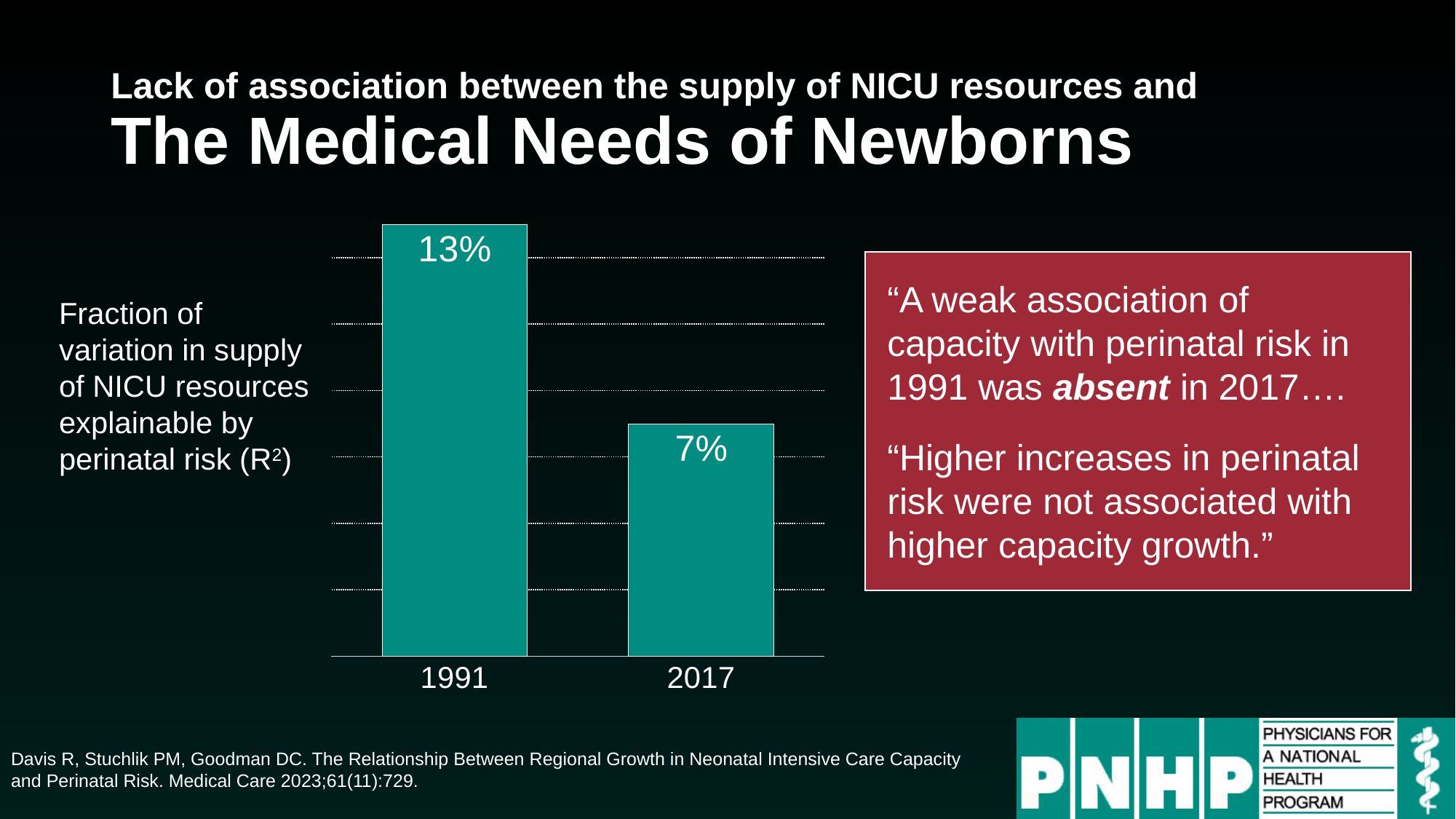
What colour are the bars in the chart? teal What is the value for 2017? 7% How many bars are shown in the chart? 2 Which year has the higher value? 1991 Which year has the lower value? 2017 What quantity does the chart plot, according to the label to its left? Fraction of variation in supply of NICU resources explainable by perinatal risk (R2) Is the value for 1991 larger or smaller than the value for 2017? larger What is the value for 1991? 13% What is the difference between the 1991 and 2017 values? 6% Do the values rise or fall from 1991 to 2017? fall What kind of chart is shown on the slide? bar chart